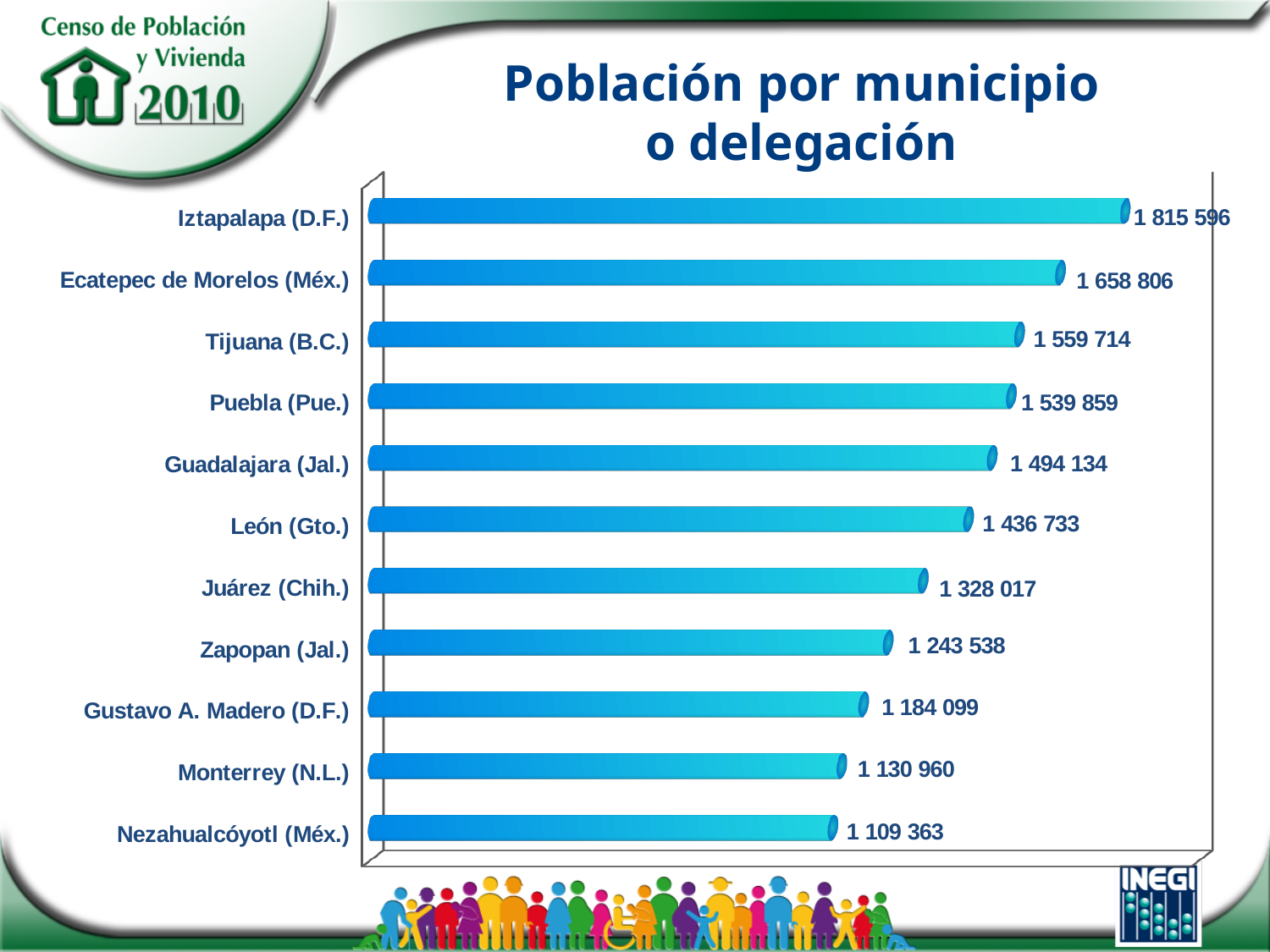
What is the population shown for Monterrey (N.L.)? 1 130 960 What is the difference in population between Monterrey (N.L.) and Nezahualcóyotl (Méx.)? 21 597 Which municipality or delegación has the lowest population on the chart? Nezahualcóyotl (Méx.) What is the difference in population between Iztapalapa (D.F.) and Ecatepec de Morelos (Méx.)? 156 790 What is the title of the chart? Población por municipio o delegación What kind of chart is shown on the slide? Bar chart Which has a larger population, Juárez (Chih.) or León (Gto.)? León (Gto.) What is the population shown for Iztapalapa (D.F.)? 1 815 596 What is the population shown for Zapopan (Jal.)? 1 243 538 How many municipalities or delegaciones are shown on the chart? 11 Which municipality or delegación has the highest population on the chart? Iztapalapa (D.F.) What is the population shown for Guadalajara (Jal.)? 1 494 134